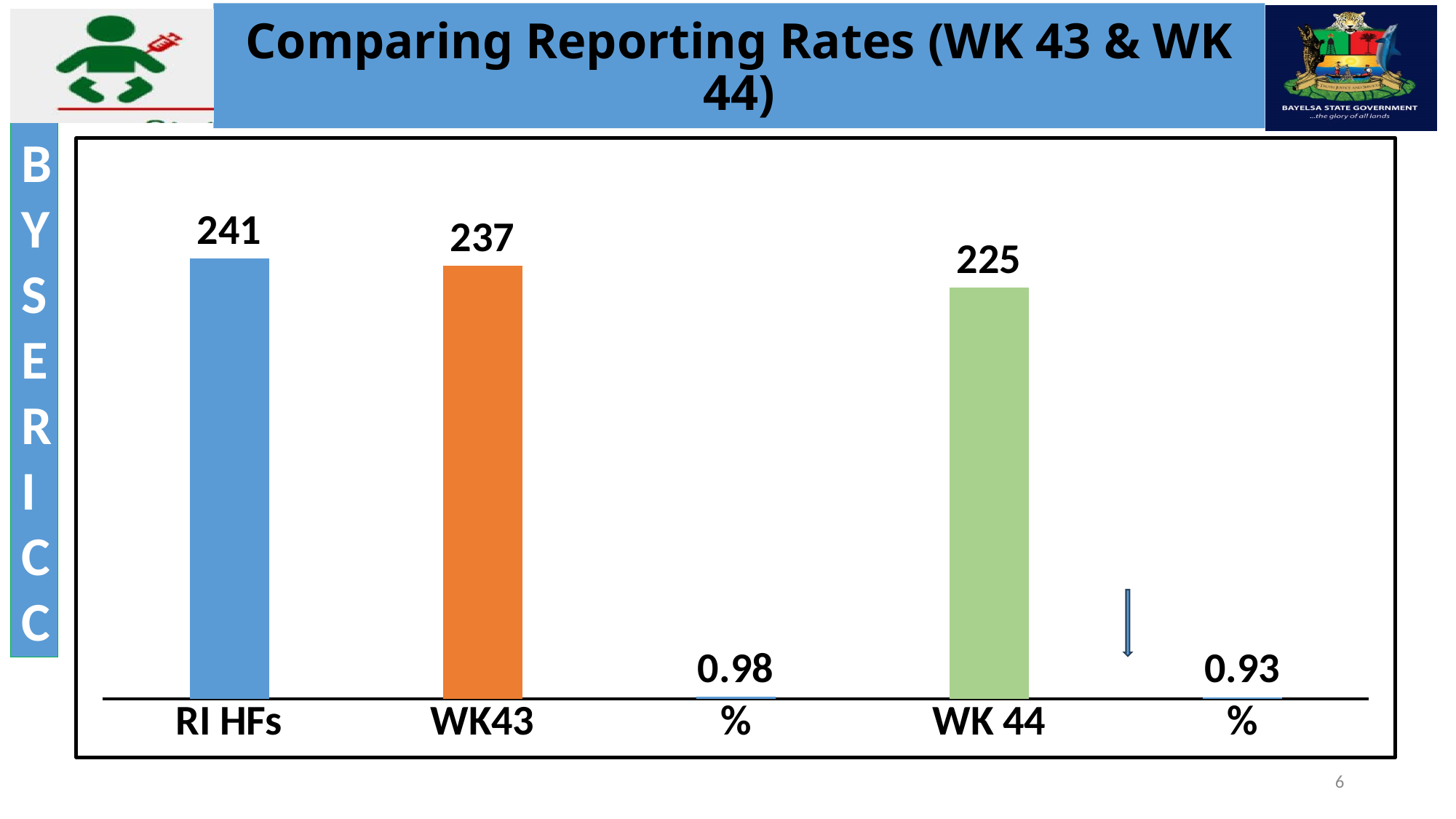
What is the value for WK 44? 225 What is the difference between the values for RI HFs and WK43? 4 What is the difference between the values for WK43 and WK 44? 12 What is the value for WK43? 237 Which category has the lowest value? % (the second one, to the right of WK 44) What is the value shown for the first % category (to the right of WK43)? 0.98 How many categories are shown on the x axis? 5 Which category has the highest value? RI HFs What is the value for RI HFs? 241 What kind of chart is shown on the slide? Bar chart What is the value shown for the second % category (to the right of WK 44)? 0.93 Which is larger, the value for WK43 or the value for WK 44? WK43